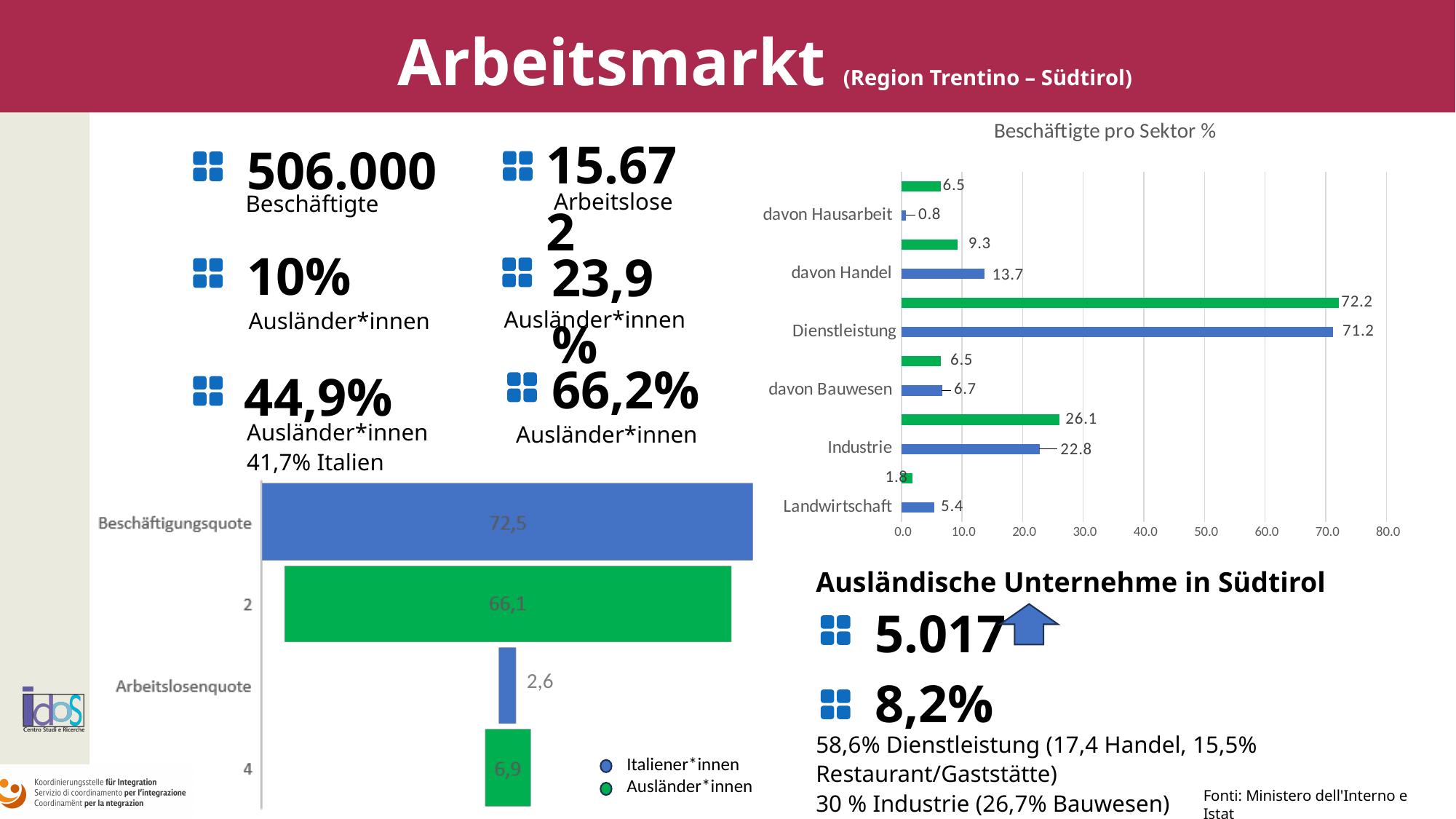
What type of chart is the chart titled 'Beschäftigte pro Sektor %'? bar chart In the bottom-left chart, which is larger for Arbeitslosenquote: the Italiener*innen bar or the Ausländer*innen bar? Ausländer*innen How many series does the legend of the bottom-left chart list? 2 In the chart titled 'Beschäftigte pro Sektor %', what is the value of the green bar for Industrie? 26.1 In the chart titled 'Beschäftigte pro Sektor %', which category has the highest green bar? Dienstleistung In the chart titled 'Beschäftigte pro Sektor %', is the blue bar for Landwirtschaft greater or less than 10.0? less In the chart titled 'Beschäftigte pro Sektor %', what is the value of the blue bar for Dienstleistung? 71.2 How many categories are shown on the y axis of the chart titled 'Beschäftigte pro Sektor %'? 6 In the chart titled 'Beschäftigte pro Sektor %', what is the difference between the blue and green bars for davon Handel? 4.4 In the bottom-left chart, what is the value of the green bar for Arbeitslosenquote? 6,9 In the bottom-left chart, what is the value of the blue bar for Beschäftigungsquote? 72,5 In the chart titled 'Beschäftigte pro Sektor %', what is the value of the blue bar for davon Hausarbeit? 0.8